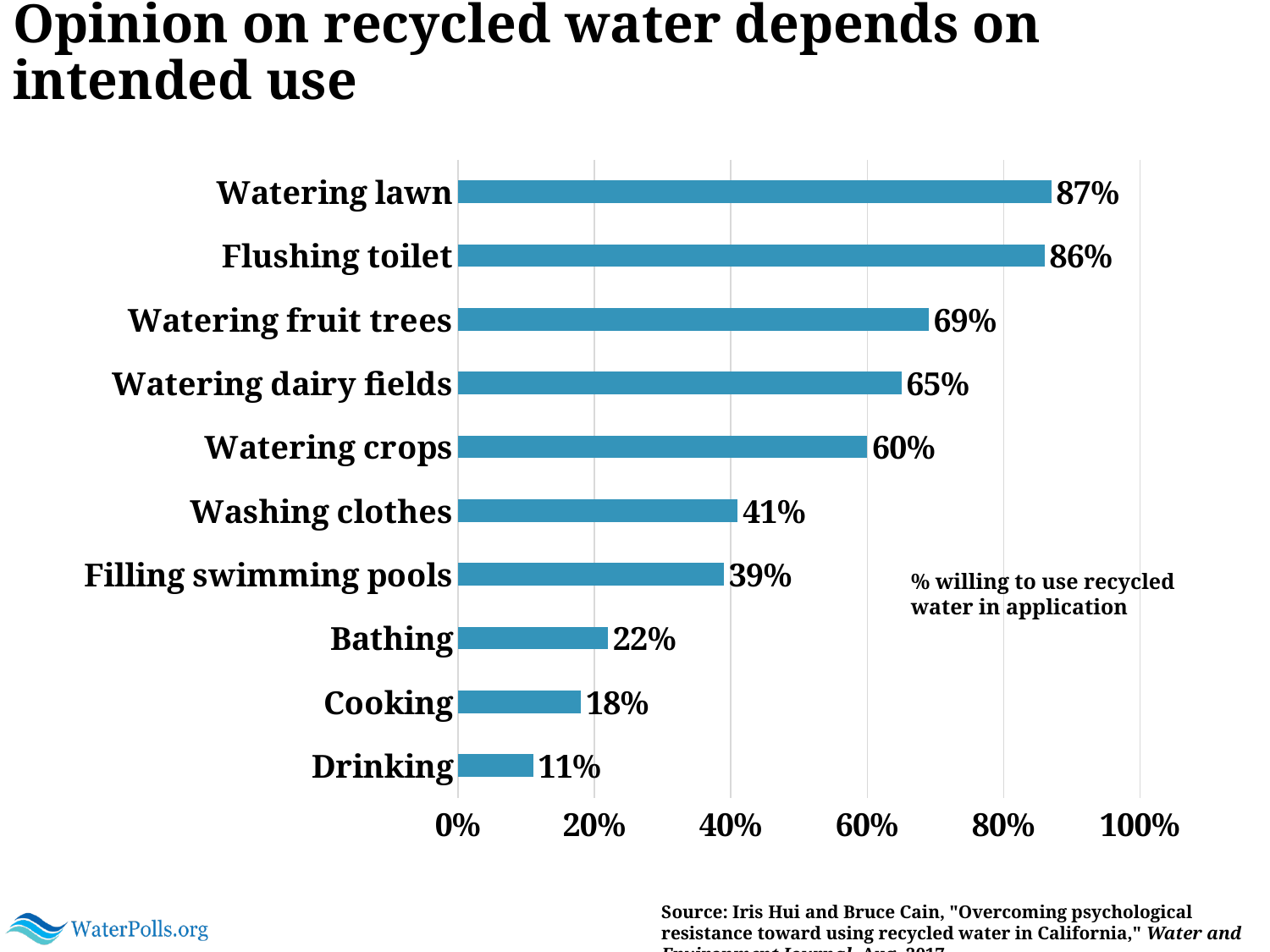
What is the difference between the values for Watering fruit trees and Watering crops? 9% What percentage is shown for Filling swimming pools? 39% What is the difference between the values for Bathing and Drinking? 11% Which application has the lowest percentage of people willing to use recycled water? Drinking How many applications are shown in the chart? 10 What is the value shown for Cooking? 18% What is the title of the slide? Opinion on recycled water depends on intended use What percentage of respondents are willing to use recycled water for watering lawn? 87% Is the value for Flushing toilet greater or less than 80%? greater What type of chart is shown on the slide? Bar chart Which has a higher value, Washing clothes or Watering dairy fields? Watering dairy fields Which application has the highest percentage of people willing to use recycled water? Watering lawn